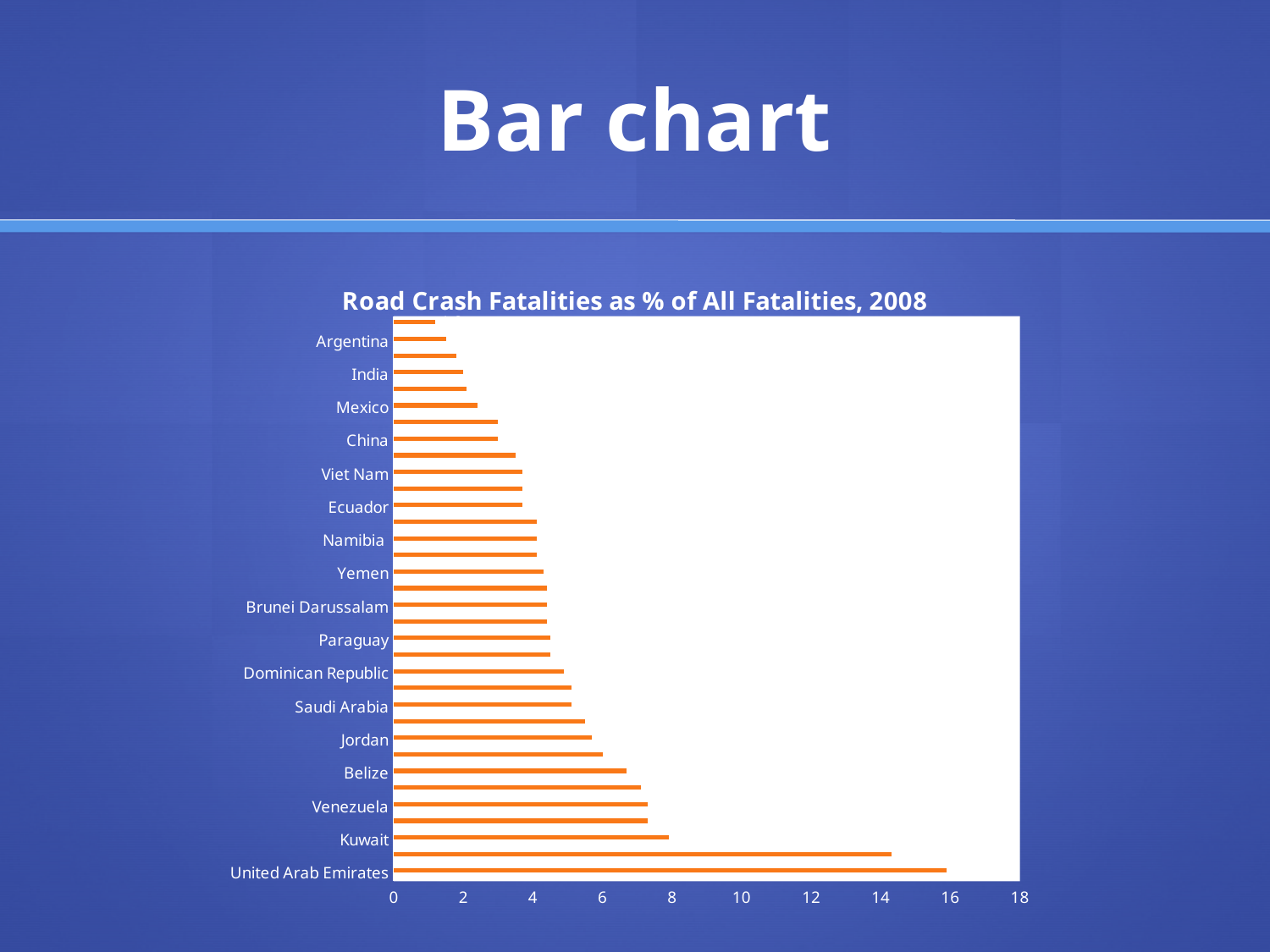
Is the value for United Arab Emirates greater or less than 14? greater Is the value for Kuwait greater or less than 6? greater Which has a larger value, Argentina or Mexico? Mexico Which country has the highest road crash fatality percentage in the chart? United Arab Emirates Is the value for China greater or less than 4? less What is the highest value shown on the horizontal axis? 18 What is the title of the chart? Road Crash Fatalities as % of All Fatalities, 2008 What kind of chart is shown on the slide? Bar chart Which has a larger value, Kuwait or Belize? Kuwait